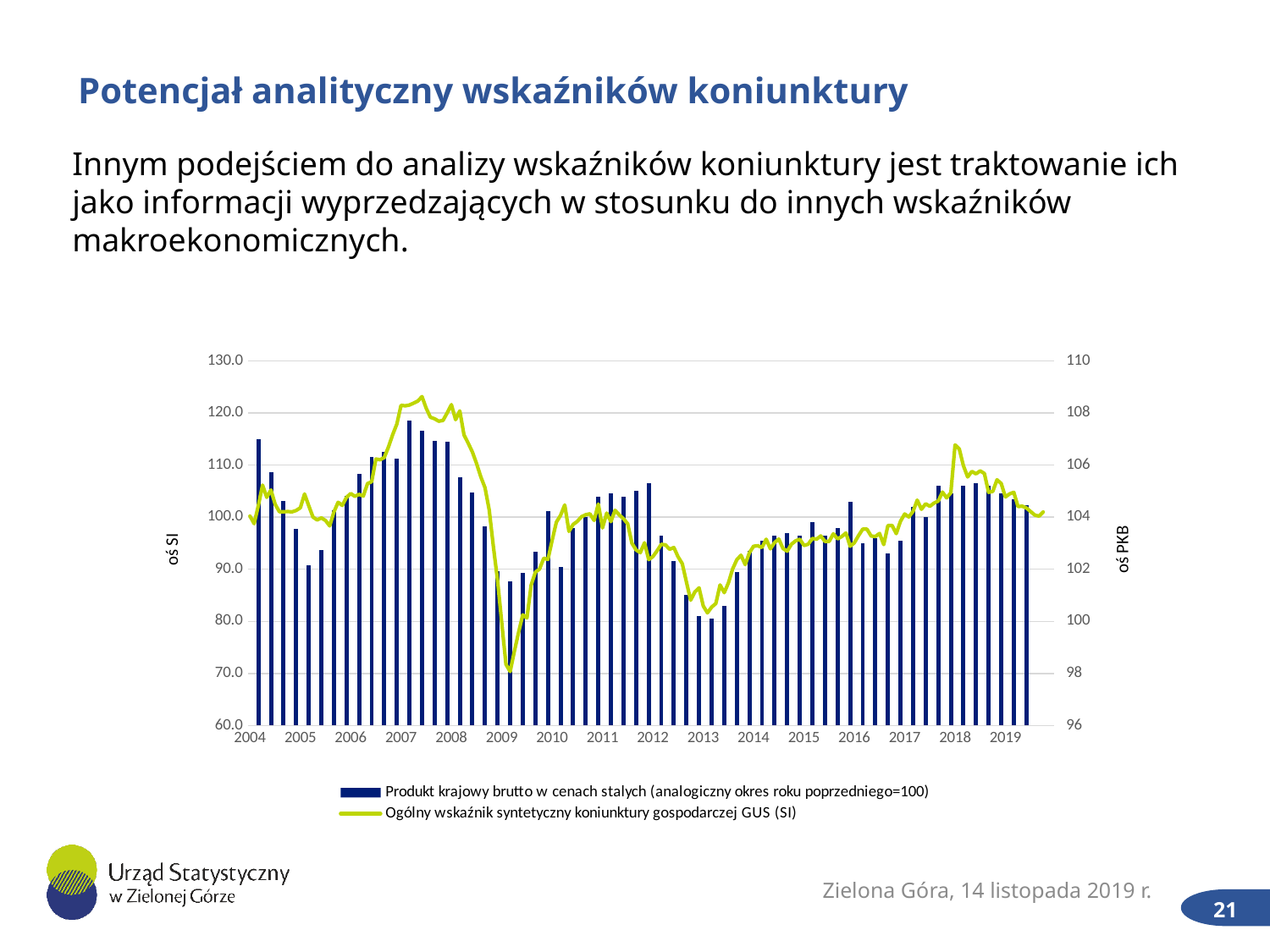
Is the peak of the SI line in 2007 greater or less than 120 on the left axis? greater Is the SI line value in 2007 larger or smaller than its value in 2013? larger Is the lowest value of the SI line (around 2009) greater or less than 80 on the left axis? less How many series does the legend list? 2 Which series is drawn as bars? Produkt krajowy brutto w cenach stalych (analogiczny okres roku poprzedniego=100) What is the title of the left vertical axis? oś SI How many years are labelled on the x axis? 16 Does the SI line rise or fall between 2007 and 2009? fall In which year does the SI line reach its highest value? 2007 Does the SI line rise or fall between 2013 and 2018? rise In which year does the SI line reach its lowest value? 2009 What kind of chart is shown on the slide? A combined bar and line chart